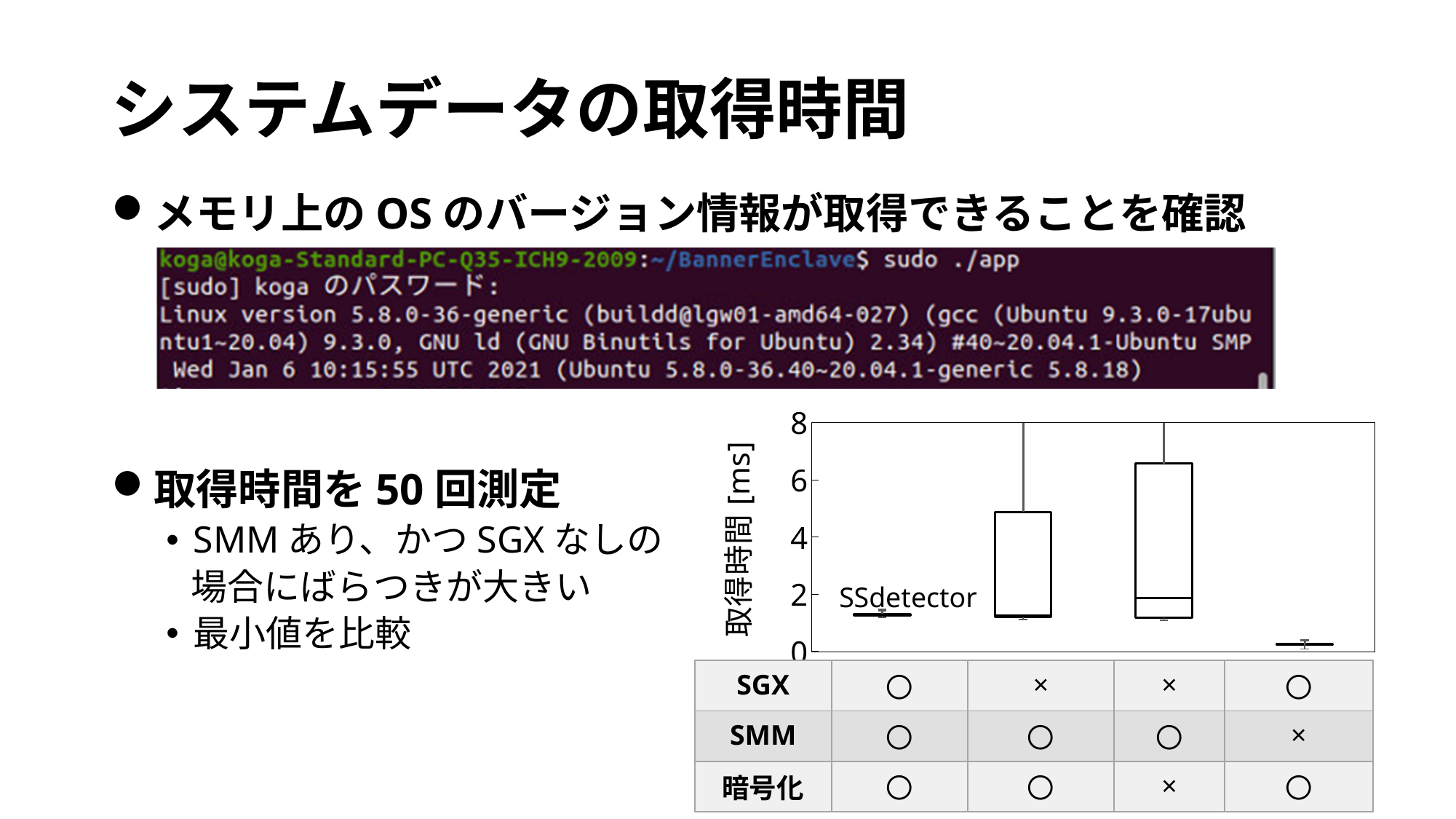
Is the top of the box for the second configuration (SGX × / SMM ○ / 暗号化 ○) greater or less than 4 ms? greater Which box is the first box (SSdetector) or the fourth box (SMM ×) higher in acquisition time? First box (SSdetector) Is the value for the first box (SSdetector, SGX ○ / SMM ○ / 暗号化 ○) greater or less than 2 ms? less What is the label of the y axis of the chart? 取得時間 [ms] Is the top of the box for the second configuration (SGX × / SMM ○ / 暗号化 ○) greater or less than 6 ms? less What is the highest tick value shown on the y axis? 8 How many boxes (configurations) are plotted in the chart? 4 What kind of chart is shown on the slide? Box plot Which configuration has the lowest acquisition time in the chart? SGX ○ / SMM × / 暗号化 ○ (fourth box) Which configuration shows the largest box (widest spread) in the chart? SGX × / SMM ○ / 暗号化 × (third box)